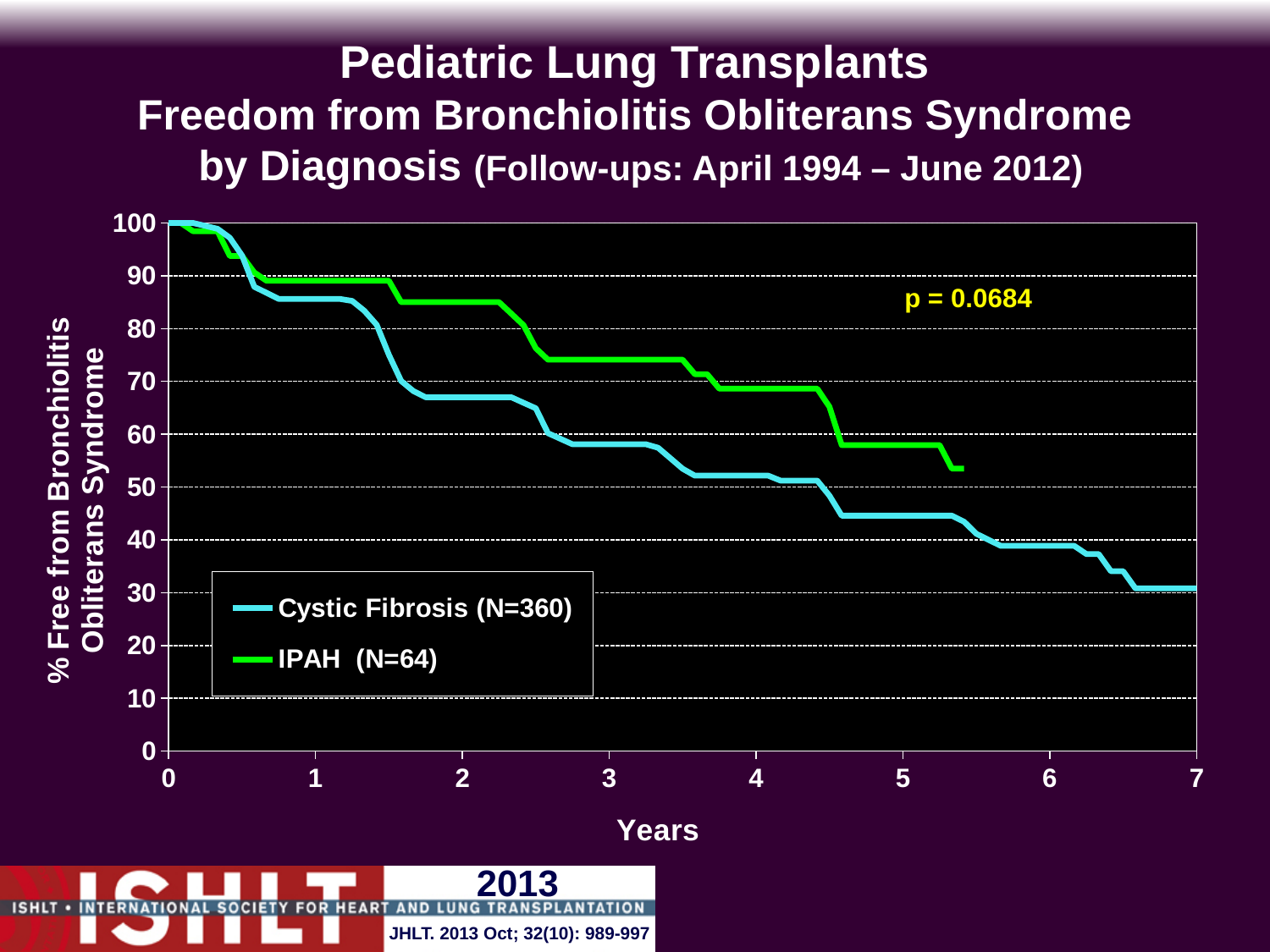
What p-value is shown on the chart? p = 0.0684 Is the value for Cystic Fibrosis at year 2 greater or less than 70? less Do the values for IPAH rise or fall as years increase? fall How many series does the legend list? 2 At year 3, which series has the higher value, Cystic Fibrosis or IPAH? IPAH What is the N for the Cystic Fibrosis series in the legend? N=360 Is the value for IPAH at year 3 greater or less than 70? greater Is the value for Cystic Fibrosis at year 7 greater or less than 40? less What is the value for Cystic Fibrosis at year 0? 100 What kind of chart is shown on the slide? line chart